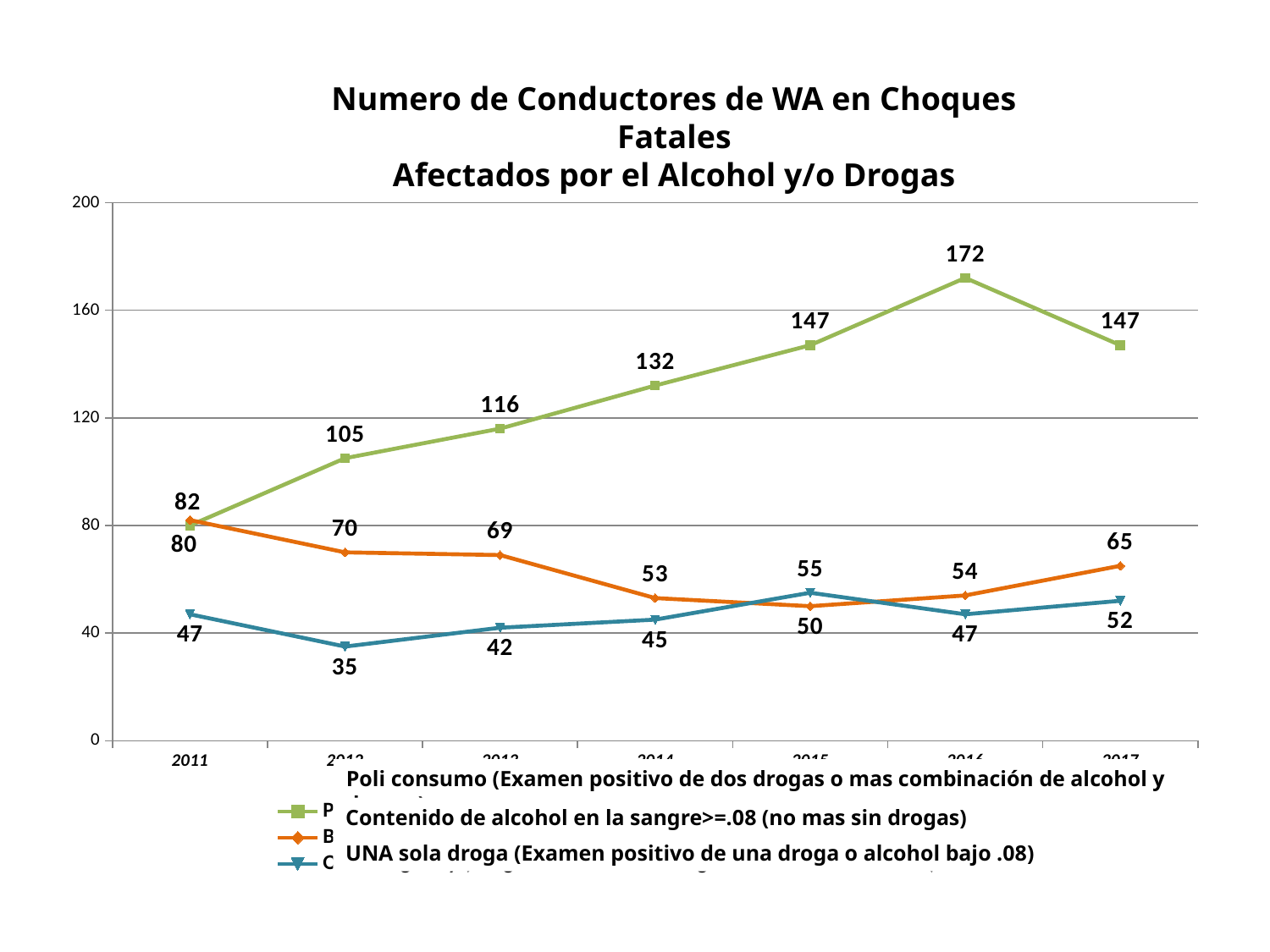
What type of chart is shown on the slide? line chart What is the value of the Contenido de alcohol en la sangre>=.08 series in 2014? 53 In which year is the UNA sola droga series at its lowest value? 2012 What is the value of the Poli consumo series in 2016? 172 What is the title of the chart? Numero de Conductores de WA en Choques Fatales Afectados por el Alcohol y/o Drogas In 2015, which series has the larger value: Contenido de alcohol en la sangre>=.08 or UNA sola droga? UNA sola droga In which year does the Poli consumo series reach its highest value? 2016 How many series does the legend list? 3 What is the difference between the Poli consumo values in 2016 and 2017? 25 What is the value of the UNA sola droga series in 2012? 35 How many years are plotted along the x axis? 7 Does the Contenido de alcohol en la sangre>=.08 series generally rise or fall from 2011 to 2015? fall